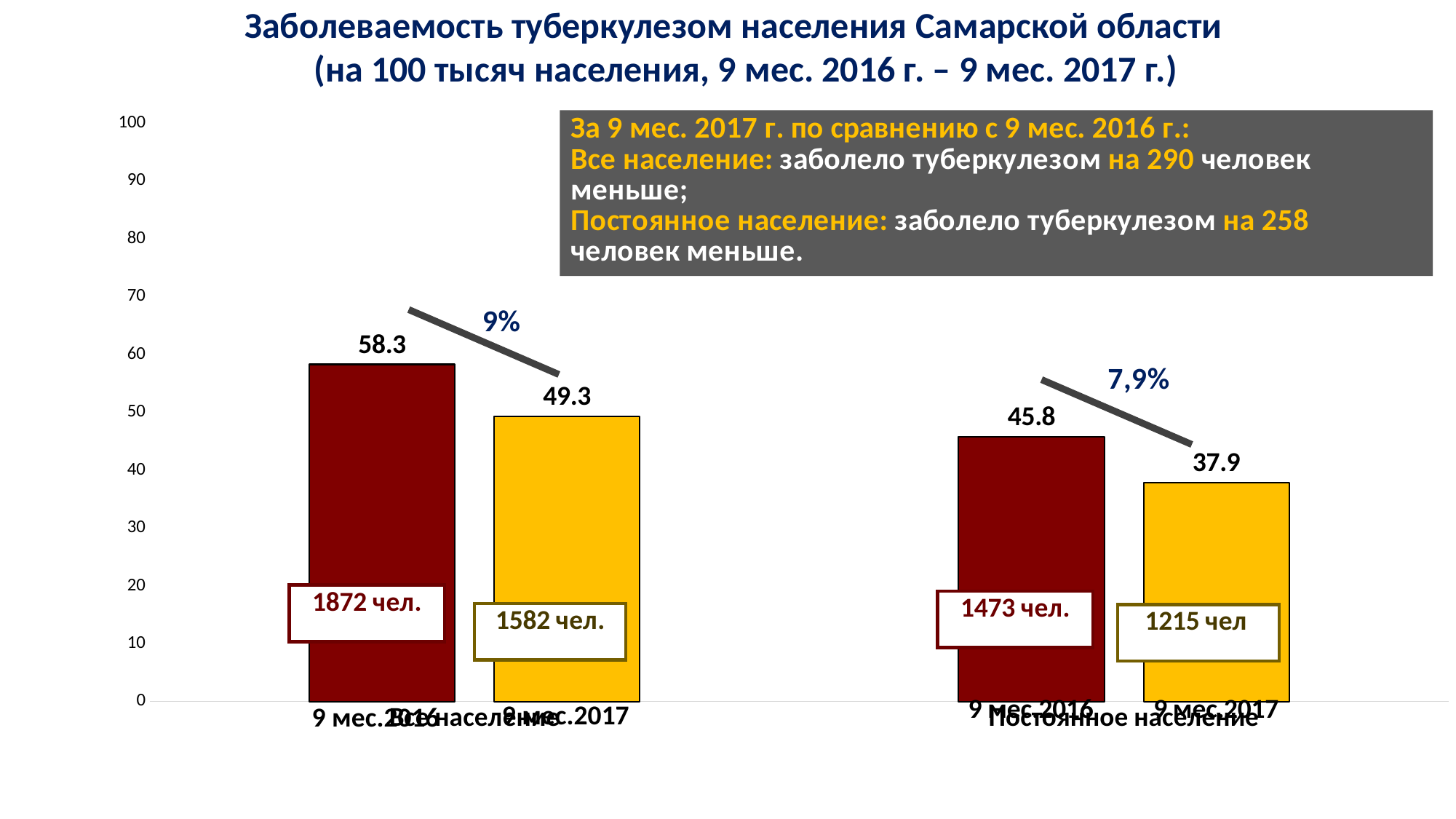
What kind of chart is shown on the slide? Bar chart Which bar has the highest value on the chart? 9 мес.2016, Все население (58.3) What is the value for 9 мес.2017 in the Постоянное население group? 37.9 How many bars are plotted on the chart? 4 Which is larger: the 9 мес.2017 value for Все население or the 9 мес.2016 value for Постоянное население? 9 мес.2017 value for Все население (49.3) What is the value for 9 мес.2017 in the Все население group? 49.3 What is the difference between the 9 мес.2016 and 9 мес.2017 values in the Все население group? 9 What is the difference between the 9 мес.2016 and 9 мес.2017 values in the Постоянное население group? 7.9 Which bar has the lowest value on the chart? 9 мес.2017, Постоянное население (37.9) What number of people is labelled on the 9 мес.2016 bar in the Все население group? 1872 чел. What is the value for 9 мес.2016 in the Все население group? 58.3 What is the value for 9 мес.2016 in the Постоянное население group? 45.8